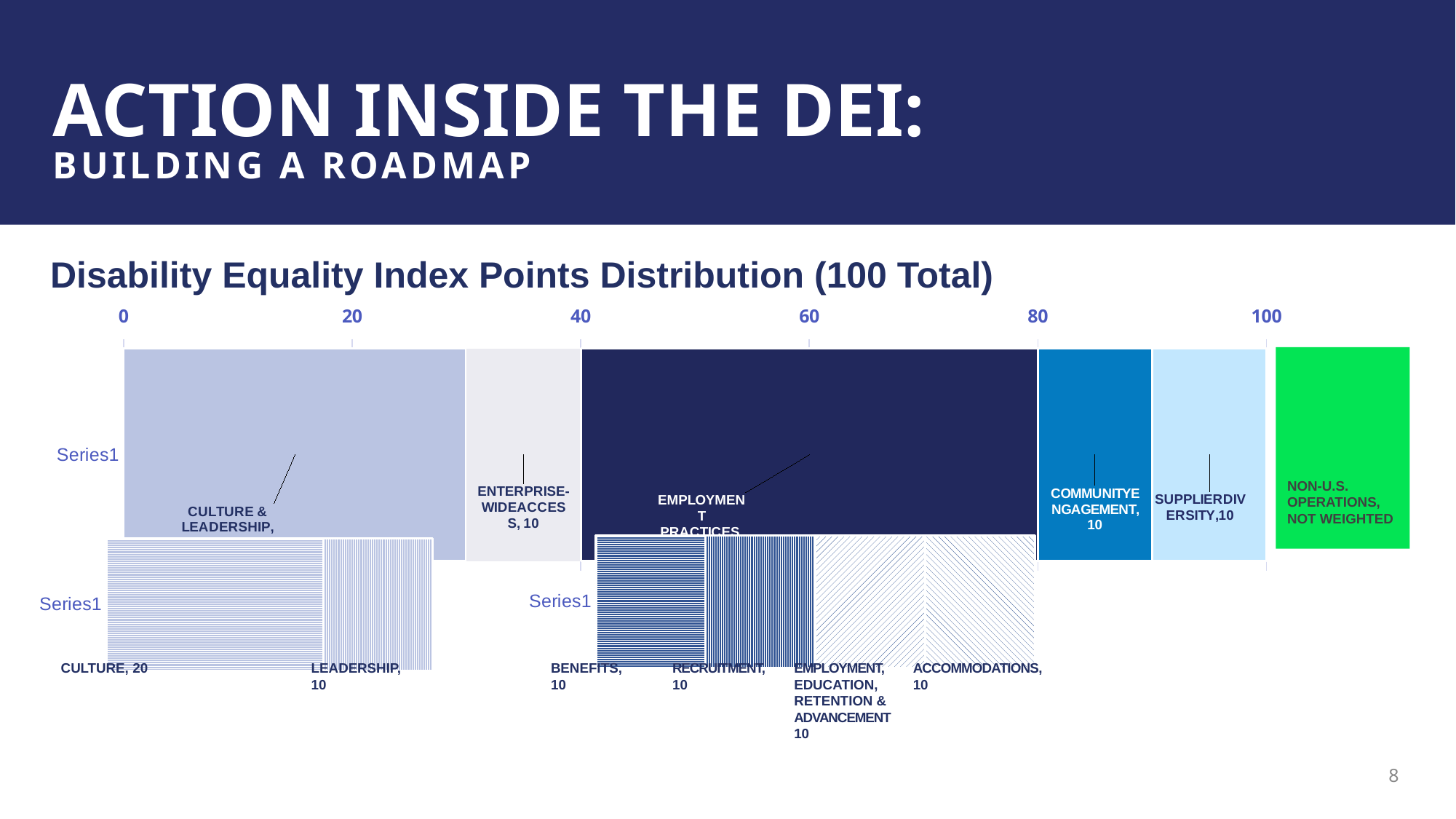
In the main chart, is the value for Culture & Leadership greater or less than 20? greater What kind of chart is the main Disability Equality Index Points Distribution chart? bar chart In the lower-left breakdown chart, how many points are assigned to Culture? 20 In the lower-right breakdown chart, what is the total of Benefits, Recruitment, Employment Education Retention & Advancement, and Accommodations? 40 What is the title of the main chart on the slide? Disability Equality Index Points Distribution (100 Total) In the lower-left breakdown chart, what is the difference between Culture and Leadership? 10 In the main chart, how many points are assigned to Supplier Diversity? 10 In the lower-left breakdown chart, which is larger, Culture or Leadership? Culture In the main chart, how many points are assigned to Enterprise-Wide Access? 10 In the main chart, how many points are assigned to Community Engagement? 10 In the main chart, is the value for Employment Practices greater or less than 20? greater In the lower-right breakdown chart, how many categories are shown? 4